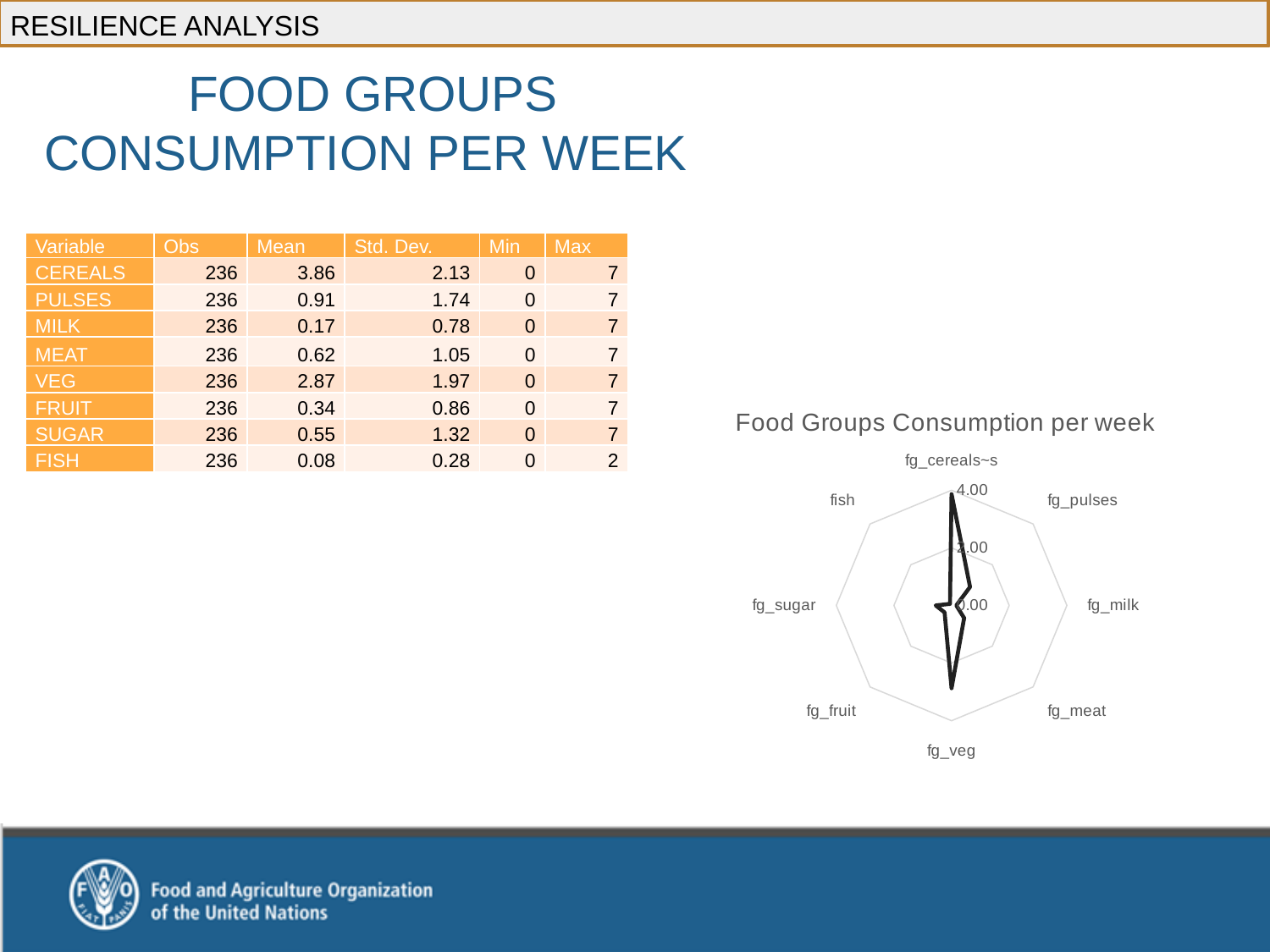
Is the value for fg_cereals~s greater or less than 2.00? greater Is the value for fg_sugar greater or less than 2.00? less How many food group categories (axes) does the radar chart have? 8 What is the highest tick value shown on the radar chart's axis? 4.00 What is the title of the chart on the slide? Food Groups Consumption per week Is the value for fg_milk greater or less than 2.00? less Which is larger in the radar chart, the value for fg_veg or the value for fg_meat? fg_veg Which is larger in the radar chart, the value for fg_cereals~s or the value for fg_veg? fg_cereals~s What kind of chart is shown on the slide? radar chart Which category has the highest value in the radar chart? fg_cereals~s